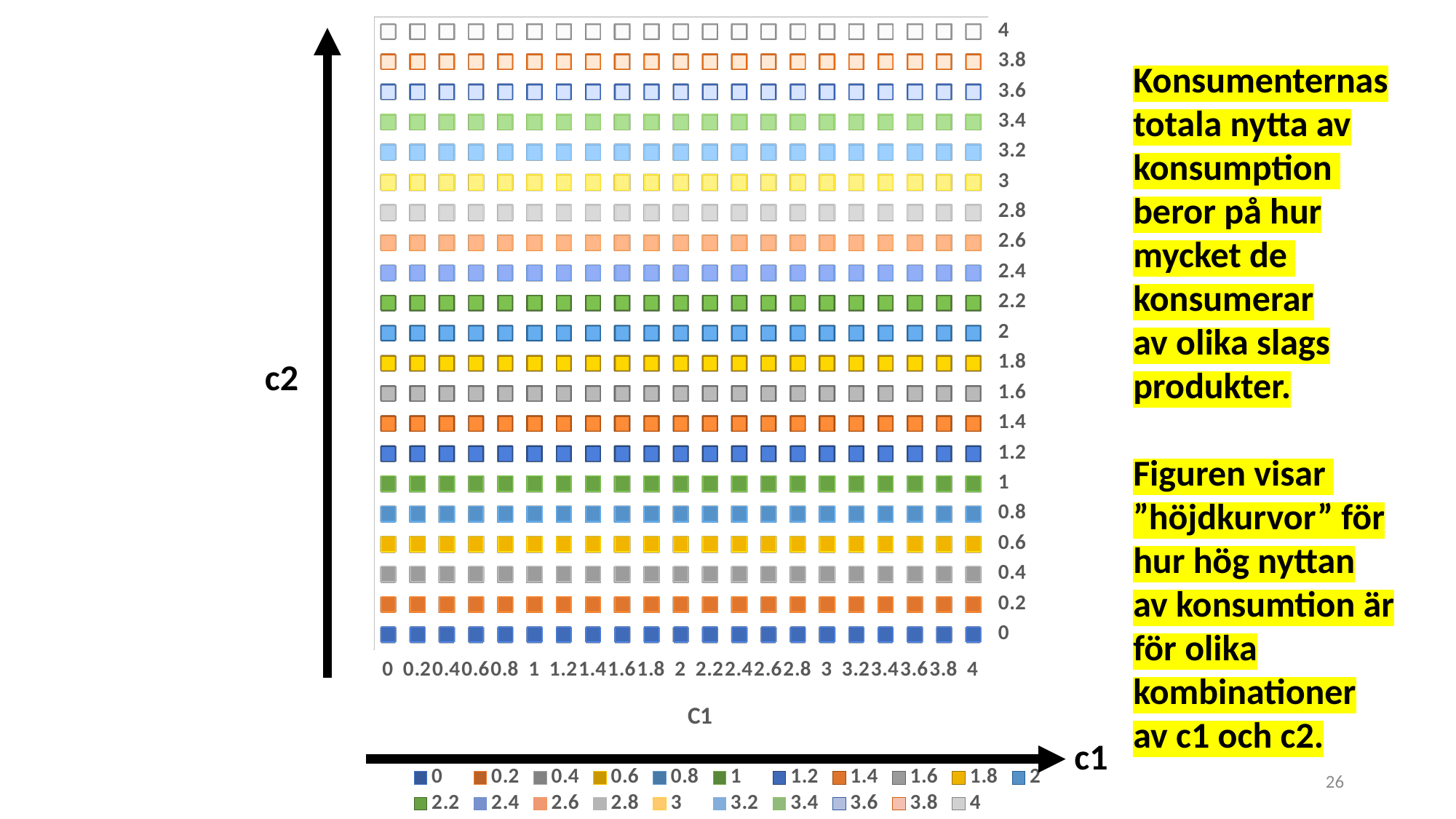
How many tick labels are shown along the x axis (C1)? 21 What value is printed at the right end of the row of markers for series 1.2? 1.2 What value is printed at the right end of the topmost row of markers? 4 Which series is plotted higher on the chart, 3.4 or 1.6? 3.4 How many series does the legend list? 21 What kind of chart is shown on the slide? scatter chart Do the values of series 2 rise, fall, or stay flat as C1 increases from 0 to 4? stay flat What is the first entry in the legend? 0 Which series is plotted lowest on the chart? 0 What is the title of the x axis? C1 Is the row of markers for series 2.6 plotted greater or less than 2 on the vertical axis? greater What is the last entry in the legend? 4